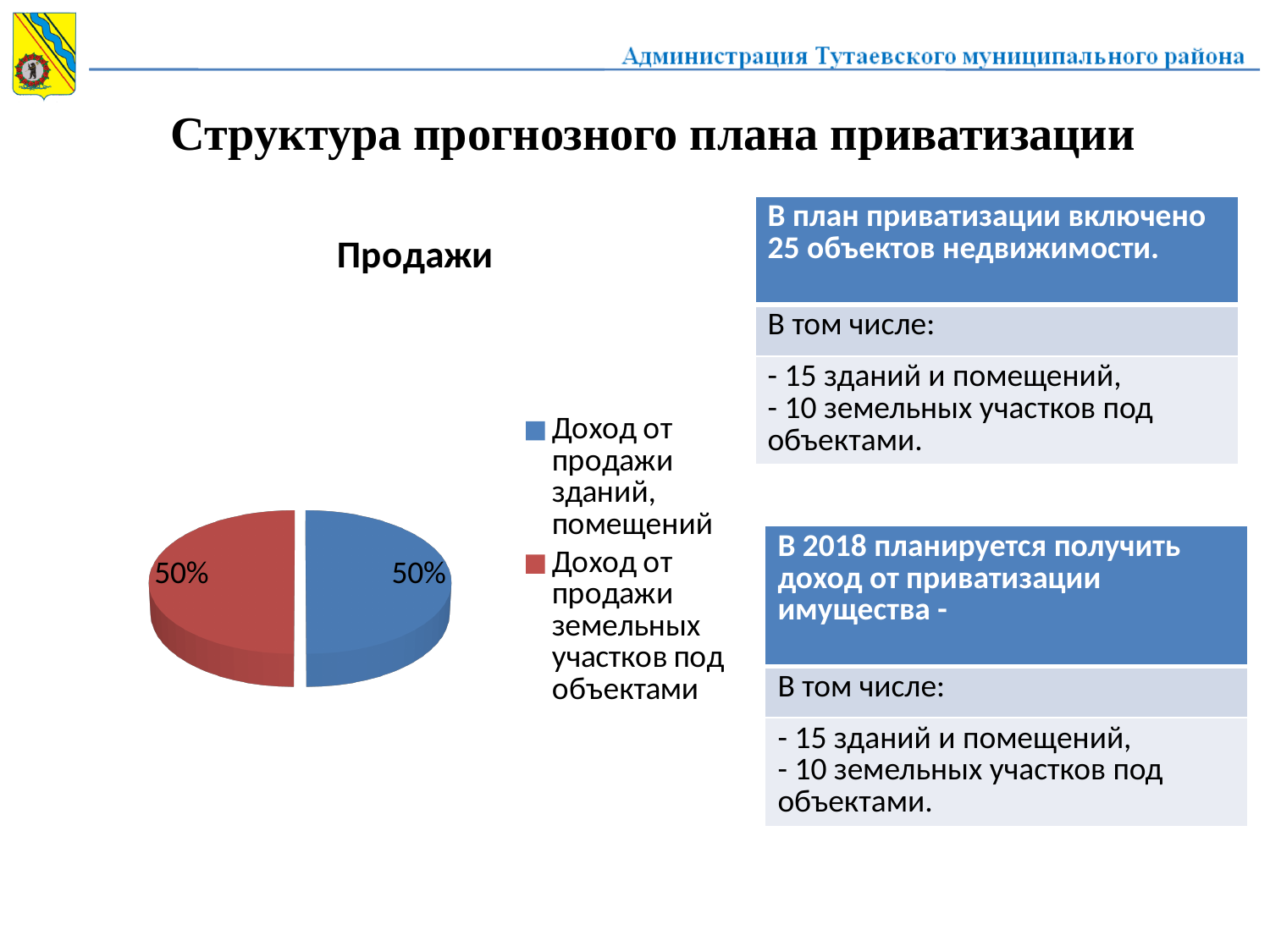
Which colour represents "Доход от продажи земельных участков под объектами" in the pie chart? red How many slices does the pie chart have? 2 What kind of chart is shown on the slide? pie chart How many entries does the legend of the pie chart list? 2 What share of the pie does "Доход от продажи земельных участков под объектами" take? 50% What is the difference between the shares of "Доход от продажи зданий, помещений" and "Доход от продажи земельных участков под объектами"? 0% Is the share for "Доход от продажи земельных участков под объектами" greater or less than 60%? less What is the title of the pie chart? Продажи What share of the pie does "Доход от продажи зданий, помещений" take? 50% Is the share for "Доход от продажи зданий, помещений" greater or less than 40%? greater